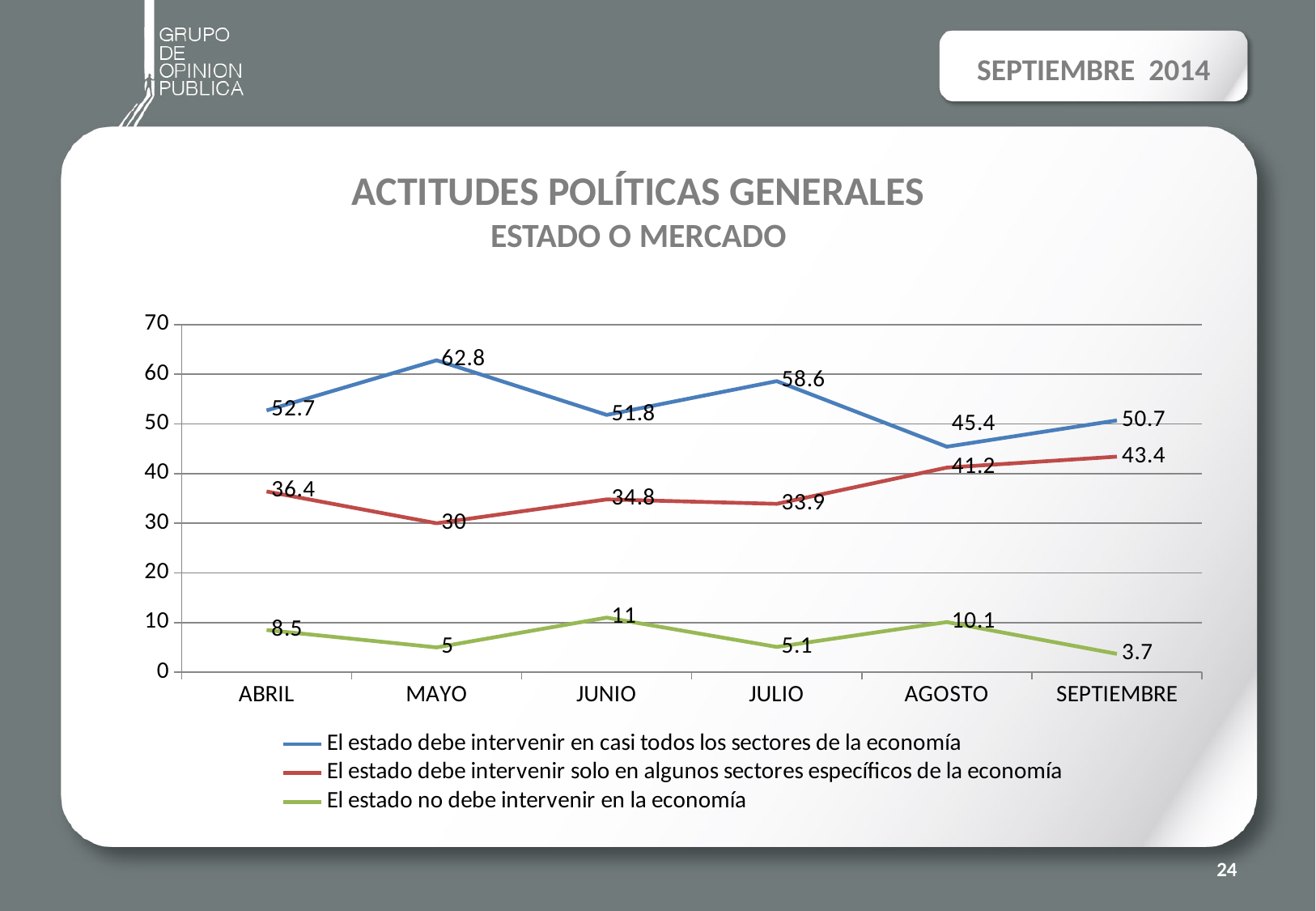
How many series does the legend list? 3 Which is larger in AGOSTO: the value for 'El estado debe intervenir en casi todos los sectores de la economía' or for 'El estado debe intervenir solo en algunos sectores específicos de la economía'? El estado debe intervenir en casi todos los sectores de la economía What kind of chart is shown on the slide? line chart What is the value for SEPTIEMBRE in the series 'El estado debe intervenir solo en algunos sectores específicos de la economía'? 43.4 In which month is the series 'El estado debe intervenir en casi todos los sectores de la economía' highest? MAYO In which month is the series 'El estado no debe intervenir en la economía' lowest? SEPTIEMBRE What is the value for MAYO in the series 'El estado debe intervenir en casi todos los sectores de la economía'? 62.8 Is the JULIO value for 'El estado debe intervenir en casi todos los sectores de la economía' greater or less than 50? greater What colour is the line for 'El estado no debe intervenir en la economía'? green How many months are shown on the x axis? 6 What is the difference between the ABRIL and SEPTIEMBRE values of the series 'El estado debe intervenir solo en algunos sectores específicos de la economía'? 7 What is the value for JUNIO in the series 'El estado no debe intervenir en la economía'? 11